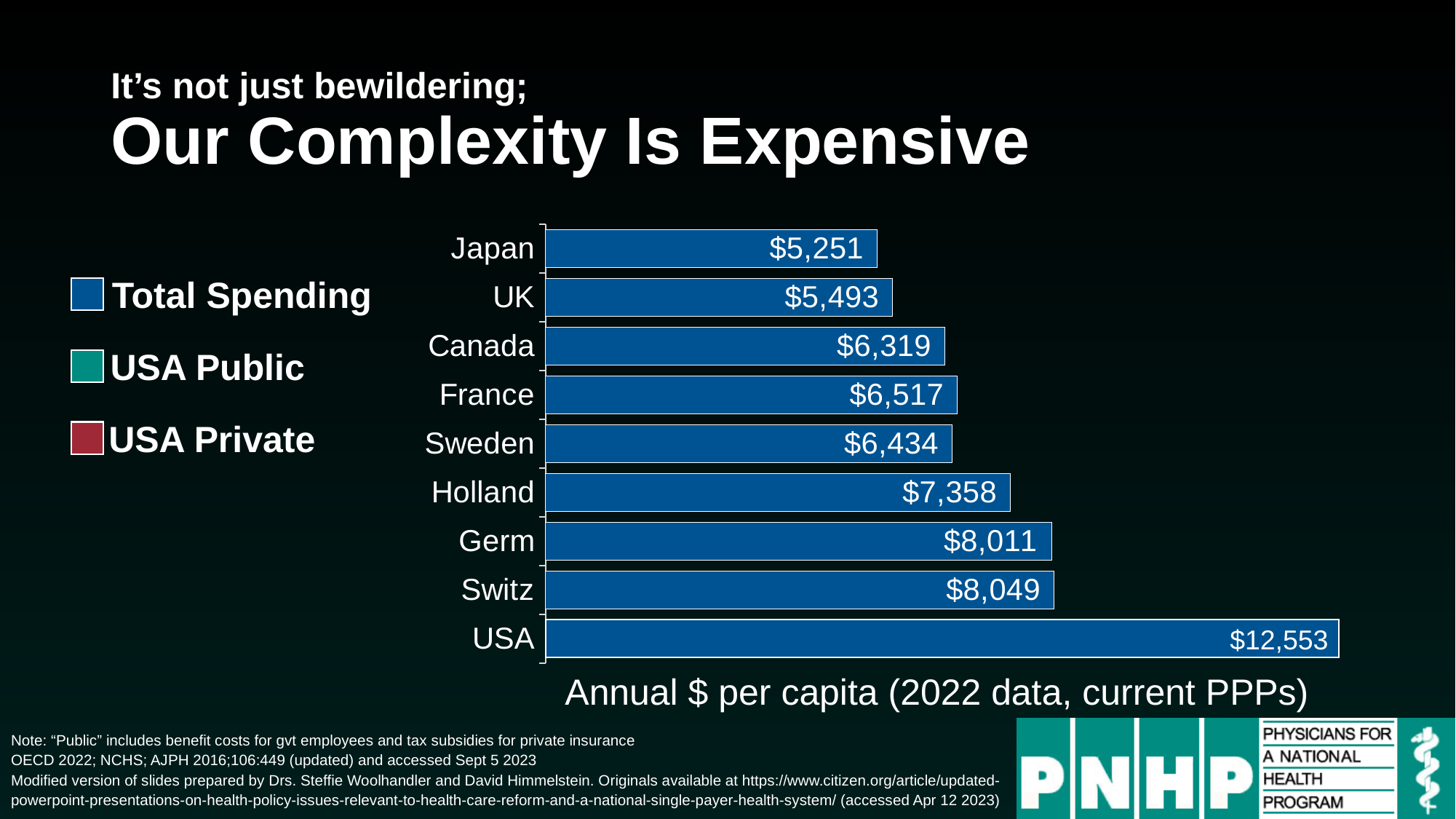
What is the annual per capita spending value shown for Canada? $6,319 What kind of chart is shown on the slide? Bar chart Which has the larger value, Switz or Germ? Switz How many entries does the legend list? 3 What is the difference between the Canada value and the UK value? $826 What is the difference between the USA value and the Switz value? $4,504 Which country has the highest annual per capita spending in the chart? USA What is the value shown for the USA bar? $12,553 How many countries are shown in the chart? 9 Which country has the lowest annual per capita spending in the chart? Japan Which has the larger value, France or Sweden? France What is the value shown for Holland? $7,358